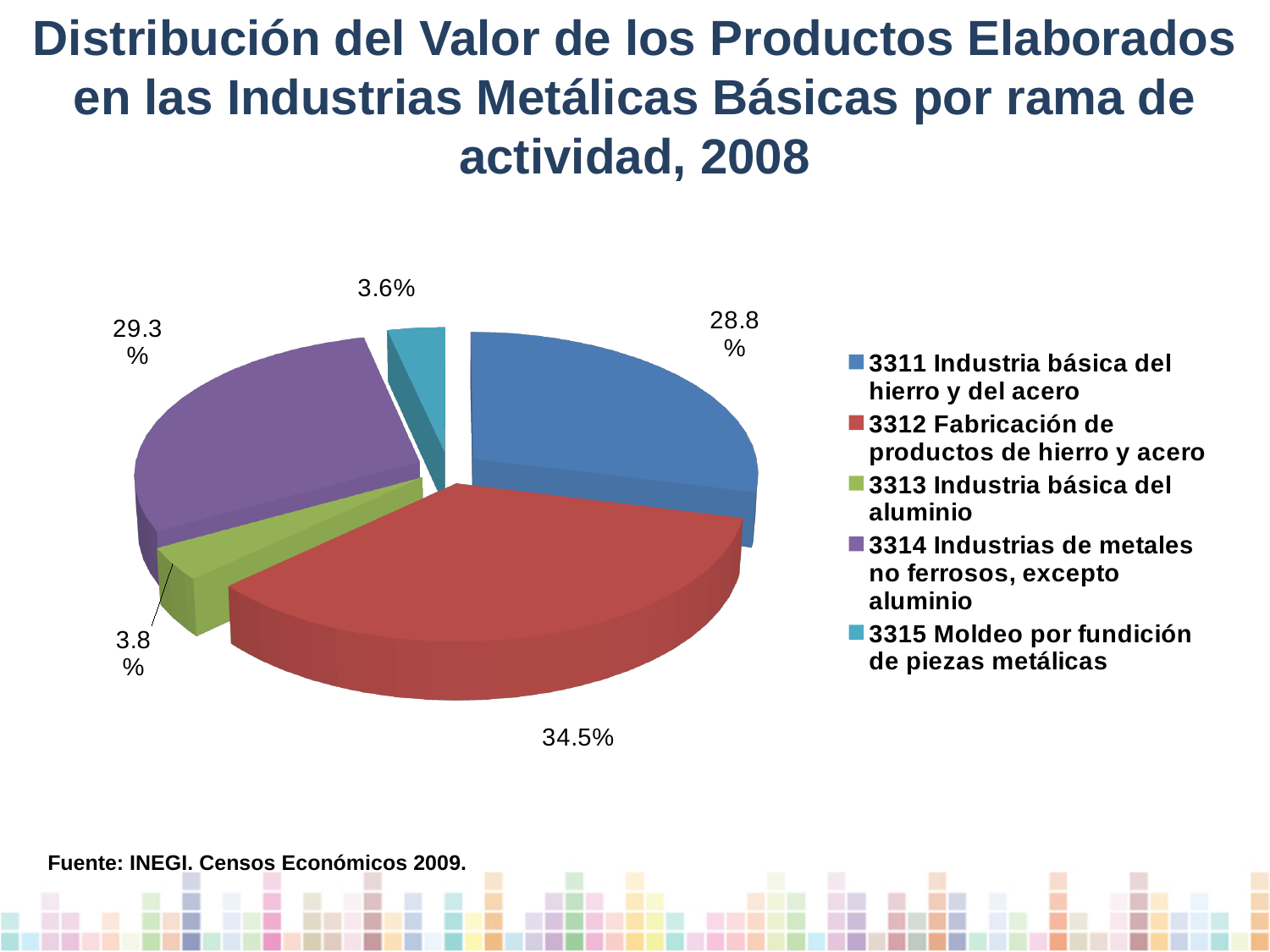
Which branch of activity has the smallest share of the value? 3315 Moldeo por fundición de piezas metálicas By how many percentage points does the share of 3312 Fabricación de productos de hierro y acero exceed that of 3311 Industria básica del hierro y del acero? 5.7 percentage points What is the source cited for the chart data? INEGI. Censos Económicos 2009. What share of the value does 3311 Industria básica del hierro y del acero represent? 28.8% What share of the value does 3314 Industrias de metales no ferrosos, excepto aluminio represent? 29.3% What share of the value does 3313 Industria básica del aluminio represent? 3.8% Which branch of activity has the largest share of the value? 3312 Fabricación de productos de hierro y acero What share of the value does 3312 Fabricación de productos de hierro y acero represent? 34.5% What type of chart is shown on the slide? Pie chart What share of the value does 3315 Moldeo por fundición de piezas metálicas represent? 3.6% How many branches of activity are shown in the pie chart? 5 Which has the larger share: 3314 Industrias de metales no ferrosos, excepto aluminio or 3311 Industria básica del hierro y del acero? 3314 Industrias de metales no ferrosos, excepto aluminio